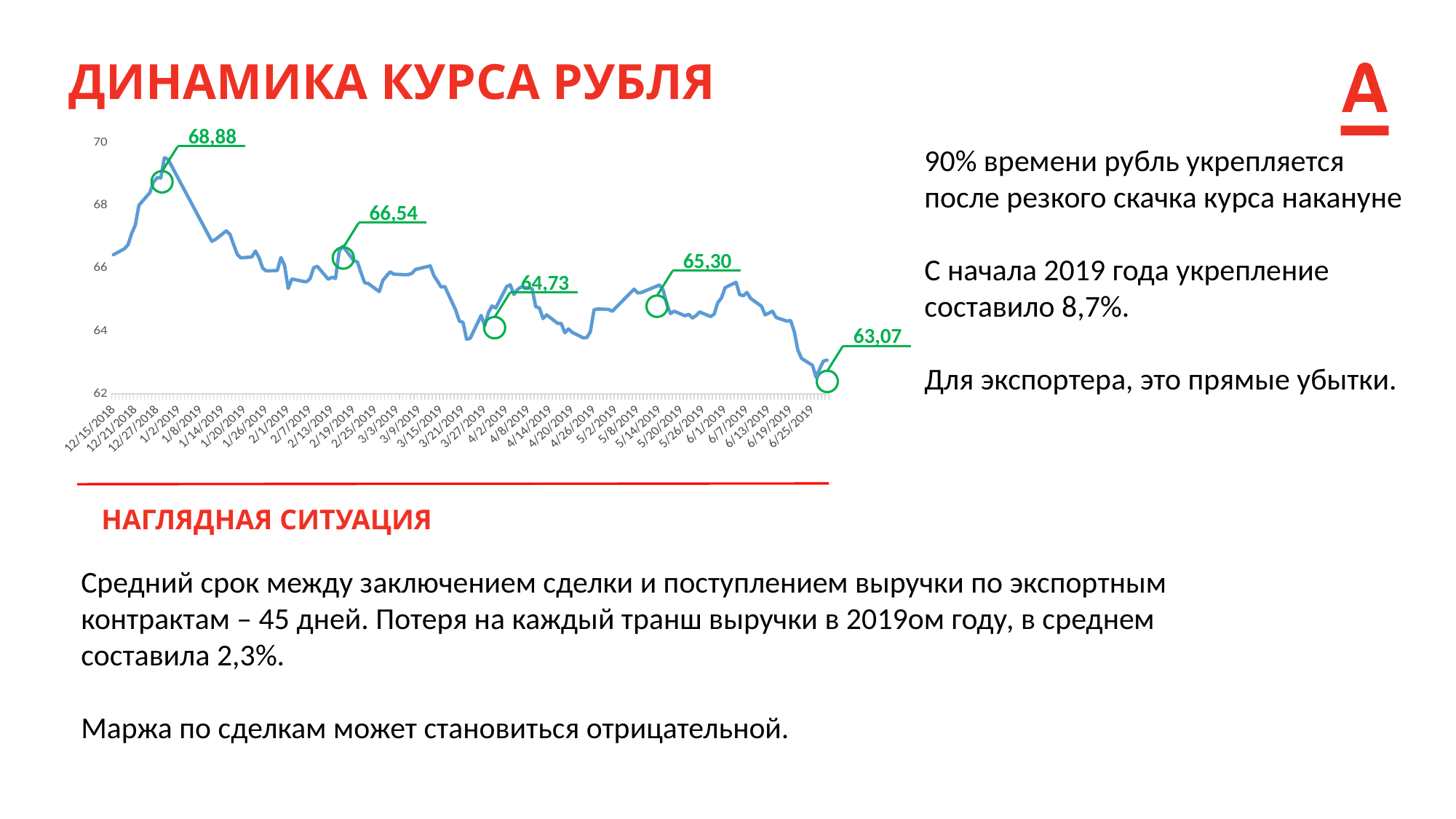
What is the title of the chart on the slide? ДИНАМИКА КУРСА РУБЛЯ Is the value at the peak of the line near 1/2/2019 greater or less than 68? greater What is the difference between the annotated values 66,54 and 64,73? 1,81 Which of the annotated values on the chart is the lowest? 63,07 How many points on the line are circled and annotated with values? 5 What value is annotated at the end of the line, near 6/25/2019? 63,07 What is the difference between the annotated values 68,88 and 63,07? 5,81 Which of the annotated values on the chart is the highest? 68,88 What kind of chart is shown on the slide? line chart What value is annotated near 2/19/2019? 66,54 What value is annotated at the peak of the line? 68,88 Which annotated value is larger: 64,73 or 65,30? 65,30